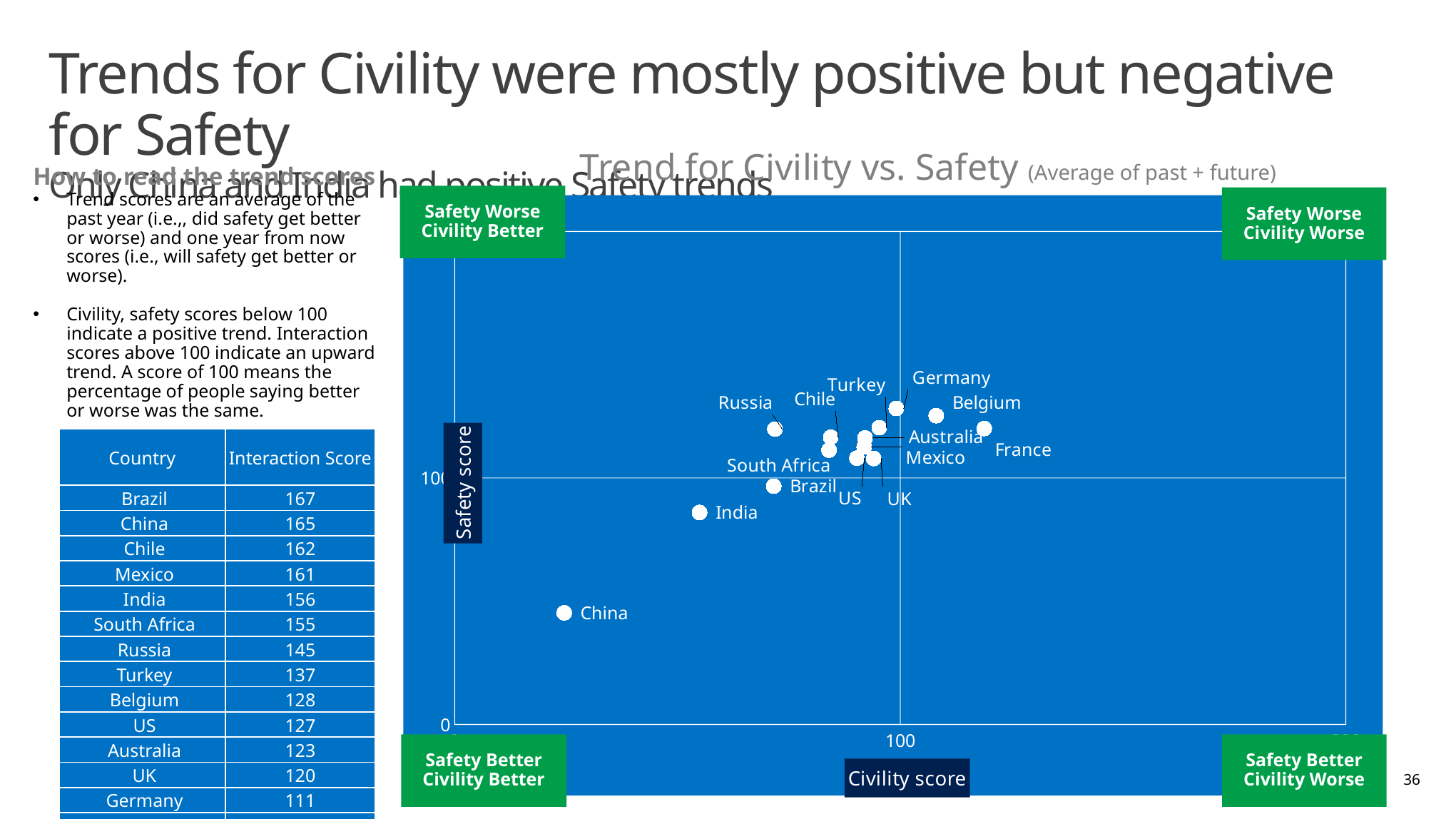
How many countries are plotted in the chart? 14 Which country has the higher Civility score, China or India? India Is the Safety score for Russia greater or less than 100? greater Which country has the lowest Safety score in the chart? China Which country has the lowest Civility score in the chart? China Is the Civility score for China greater or less than 100? less Is the Safety score for India greater or less than 100? less What kind of chart is shown on the slide? scatter chart What label is on the vertical axis of the chart? Safety score What is the title of the chart? Trend for Civility vs. Safety (Average of past + future) Which country has the highest Civility score in the chart? France